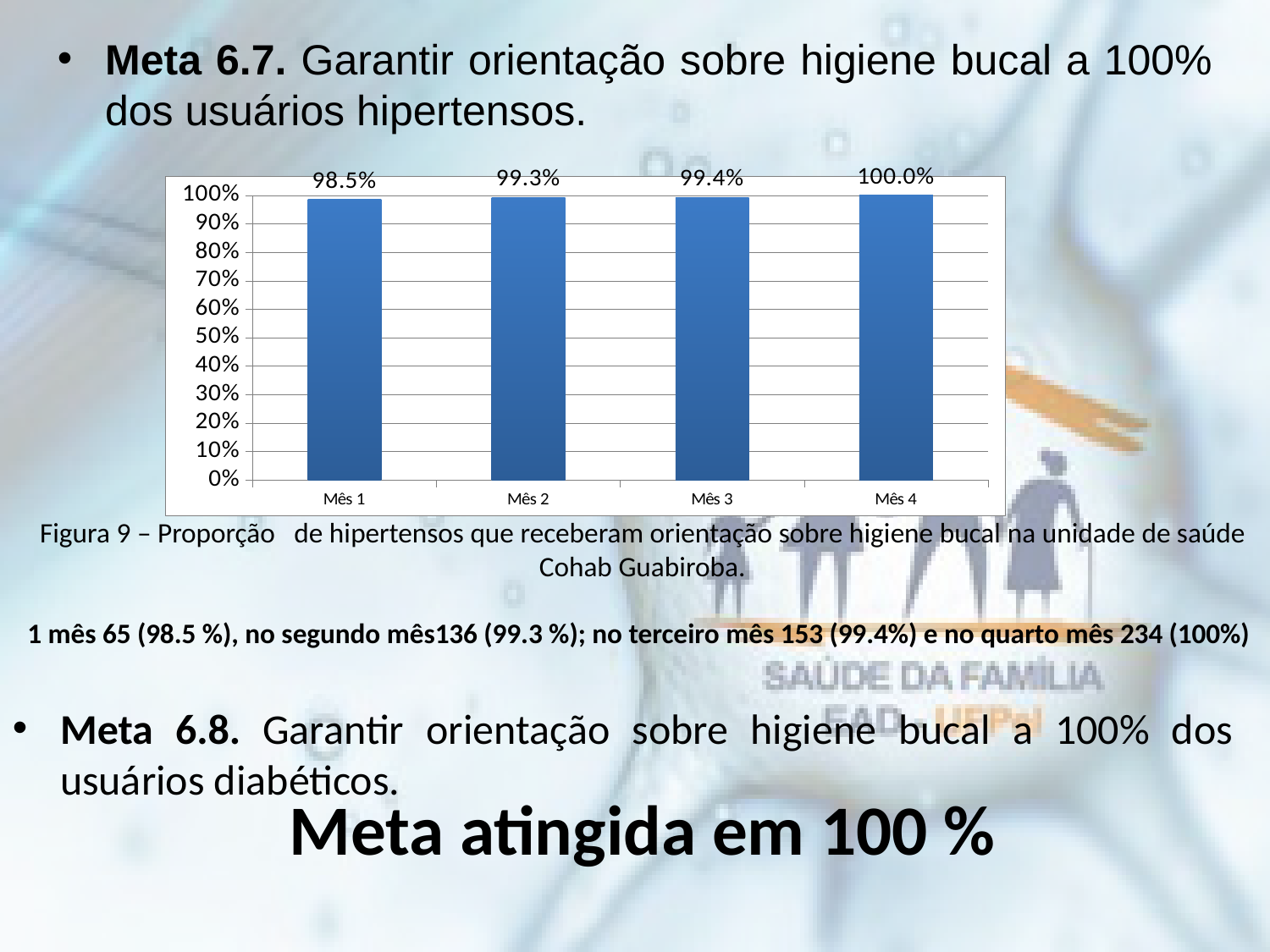
Which is larger, the value for Mês 1 or the value for Mês 4? Mês 4 What kind of chart is shown on the slide? Bar chart What is the value for Mês 1? 98.5% Which month has the highest value? Mês 4 What is the difference between the values for Mês 2 and Mês 1? 0.8% What is the value for Mês 4? 100.0% Which month has the lowest value? Mês 1 How many months are shown on the chart? 4 What is the value for Mês 3? 99.4% What is the value for Mês 2? 99.3% What is the difference between the values for Mês 4 and Mês 1? 1.5% Do the values rise or fall from Mês 1 to Mês 4? Rise